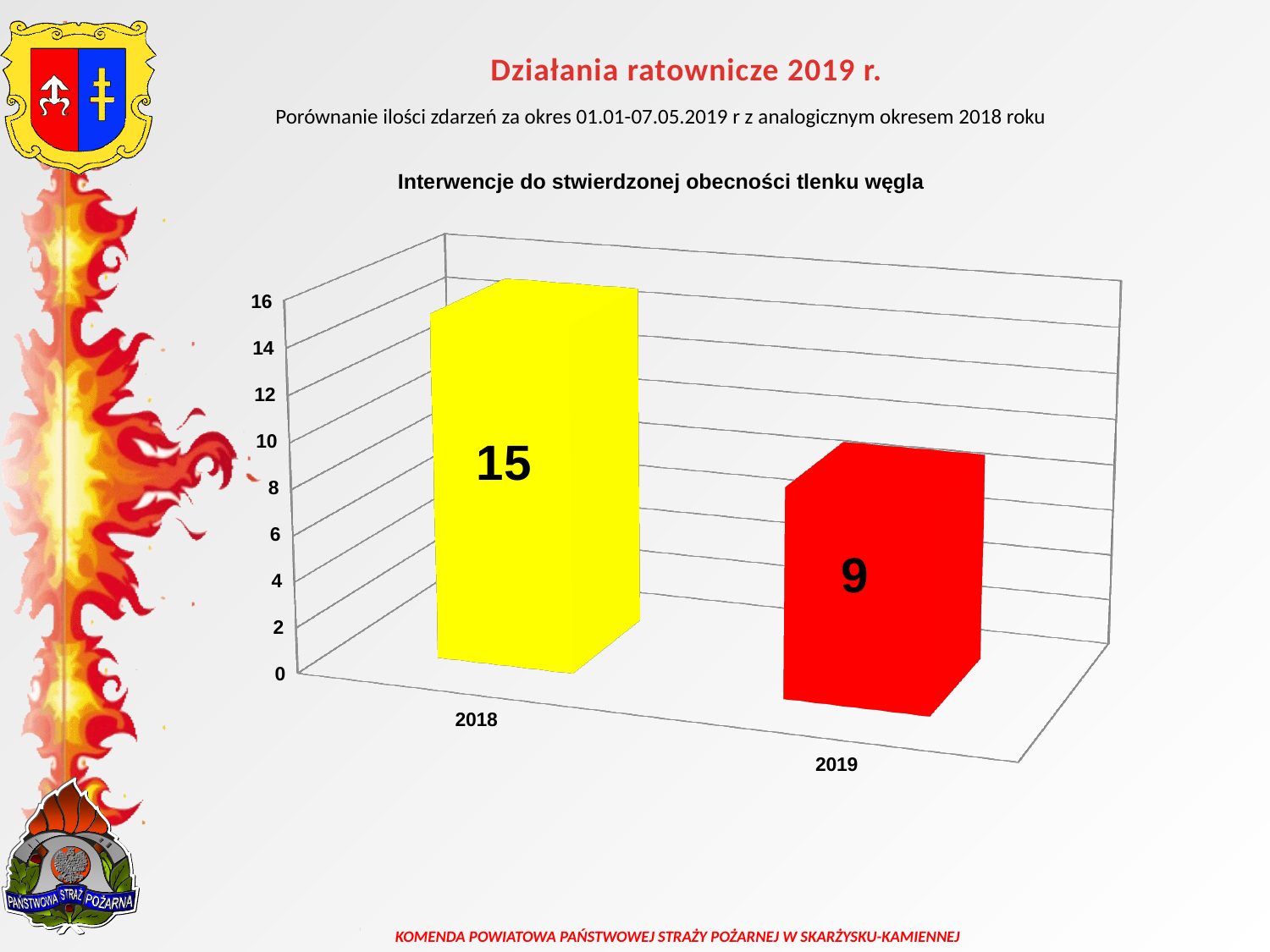
Is the value for 2019 greater or less than 10? less What kind of chart is shown on the slide? bar chart What is the difference between the values for 2018 and 2019? 6 Is the value for 2018 larger or smaller than the value for 2019? larger Which year has the lower value? 2019 How many categories are shown on the chart? 2 What is the value for 2018? 15 What is the value for 2019? 9 Do the values rise or fall from 2018 to 2019? fall Which year has the higher value? 2018 What is the title of the chart? Interwencje do stwierdzonej obecności tlenku węgla What colour is the bar for 2019? red